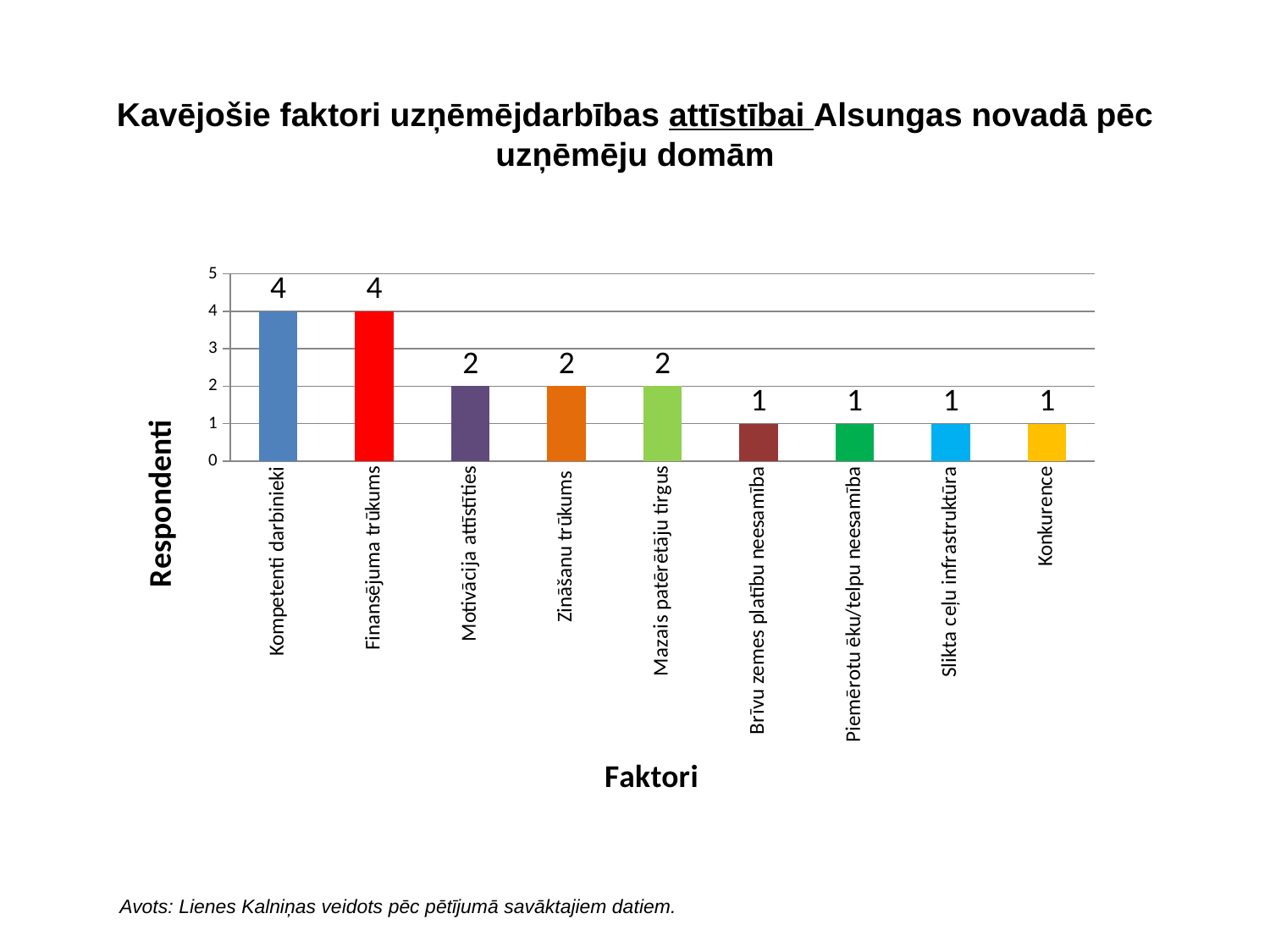
Which categories have the highest value? Kompetenti darbinieki and Finansējuma trūkums What is the difference between the values for Finansējuma trūkums and Zināšanu trūkums? 2 Is the value for Finansējuma trūkums greater or less than 3? greater What is the label of the y axis? Respondenti What kind of chart is shown on the slide? bar chart What is the value for Mazais patērētāju tirgus? 2 What is the value for Kompetenti darbinieki? 4 Which is larger, the value for Kompetenti darbinieki or the value for Konkurence? Kompetenti darbinieki Do the values rise or fall from left to right along the x axis? fall What is the value for Slikta ceļu infrastruktūra? 1 What is the value for Motivācija attīstīties? 2 How many categories are shown on the x axis? 9